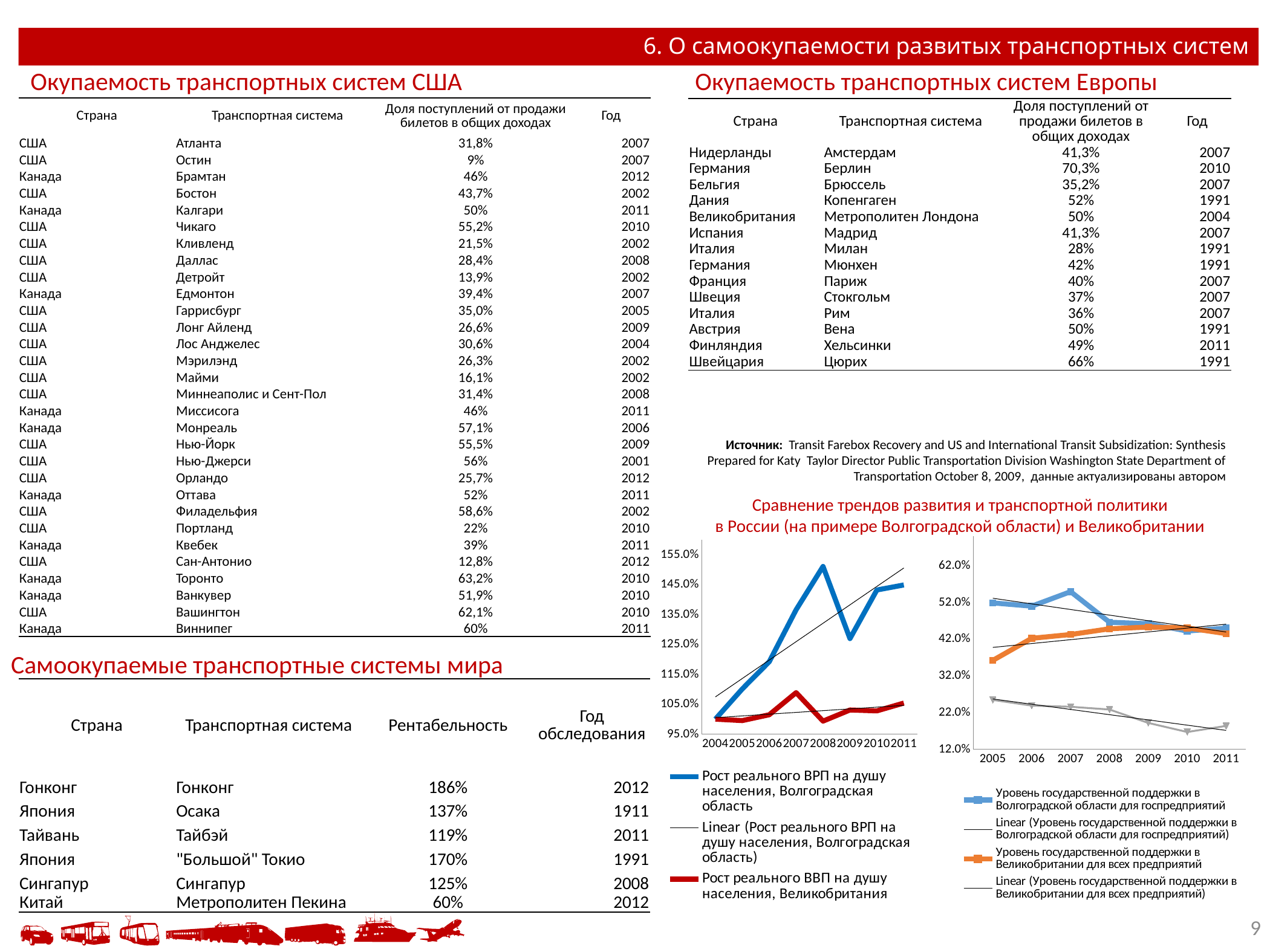
In the left chart (2004–2011), in which year is 'Рост реального ВРП на душу населения, Волгоградская область' highest? 2008 In the left chart (2004–2011), how many years are shown on the x axis? 8 In the left chart (2004–2011), is the value for 'Рост реального ВВП на душу населения, Великобритания' in 2011 greater or less than 115.0%? less What kind of chart is the left chart under 'Сравнение трендов развития и транспортной политики' (the one with years 2004–2011)? line chart In the left chart (2004–2011), is the value for 'Рост реального ВРП на душу населения, Волгоградская область' in 2008 greater or less than 145.0%? greater In the right chart (2005–2011), how many years are shown on the x axis? 7 How many entries does the legend of the right chart (2005–2011) list? 4 In the left chart (2004–2011), which series is higher in 2011: 'Рост реального ВРП на душу населения, Волгоградская область' or 'Рост реального ВВП на душу населения, Великобритания'? Рост реального ВРП на душу населения, Волгоградская область How many entries does the legend of the left chart (2004–2011) list? 3 What kind of chart is the right chart under 'Сравнение трендов развития и транспортной политики' (the one with years 2005–2011)? line chart In the right chart (2005–2011), is the value for 'Уровень государственной поддержки в Волгоградской области для госпредприятий' in 2005 greater or less than 42.0%? greater In the right chart (2005–2011), does 'Уровень государственной поддержки в Великобритании для всех предприятий' rise or fall from 2005 to 2011? rise